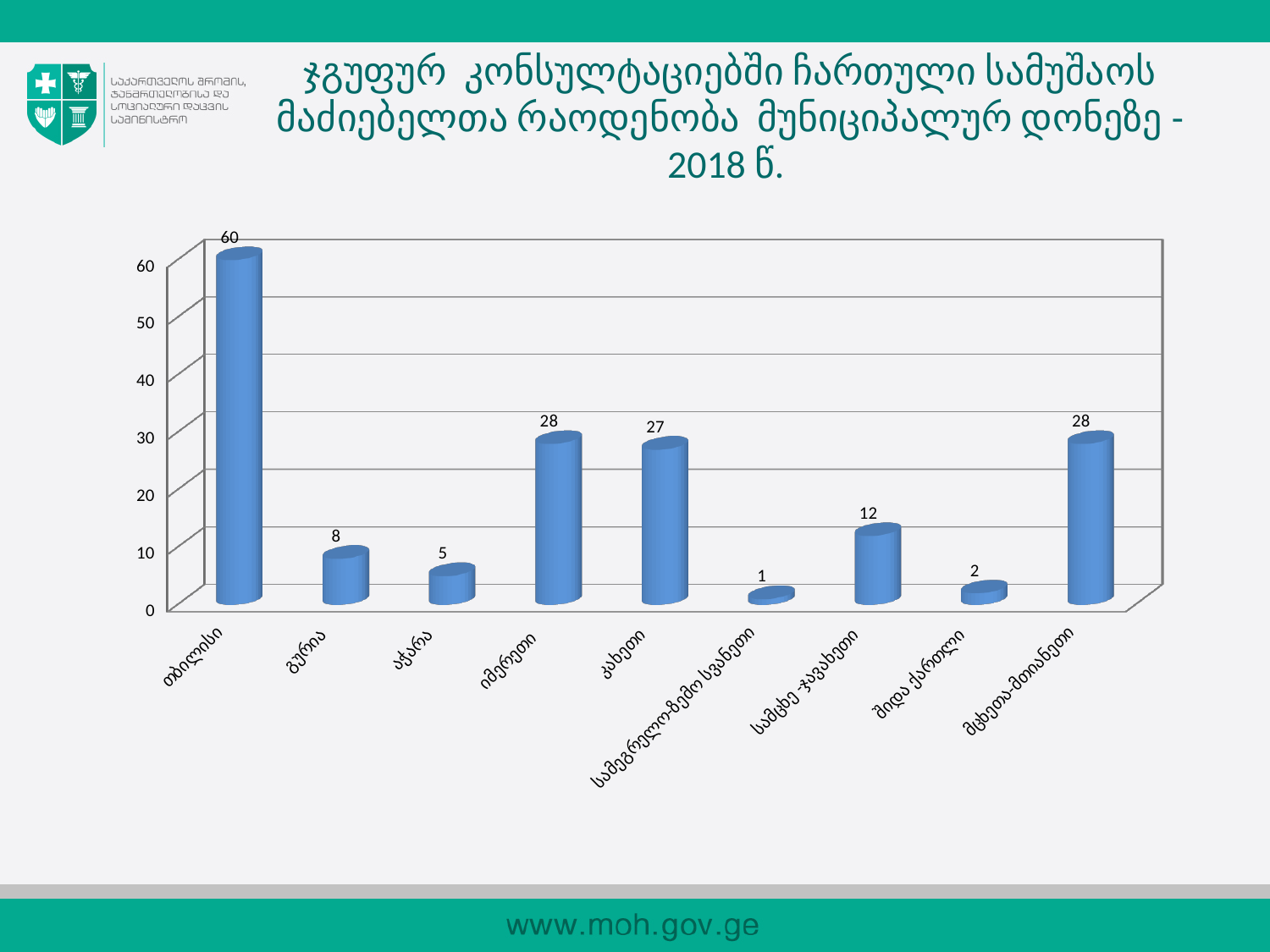
What year is mentioned in the chart title? 2018 What is the difference between the values for გურია and აჭარა? 3 What is the value for თბილისი? 60 How many categories are shown on the x axis? 9 Which category has the highest value? თბილისი What is the value for კახეთი? 27 Which is larger, the value for სამცხე-ჯავახეთი or the value for შიდა ქართლი? სამცხე-ჯავახეთი Is the value for მცხეთა-მთიანეთი greater or less than 20? greater What is the difference between the values for თბილისი and იმერეთი? 32 What kind of chart is shown on the slide? bar chart Which category has the lowest value? სამეგრელო-ზემო სვანეთი What is the value for სამცხე-ჯავახეთი? 12